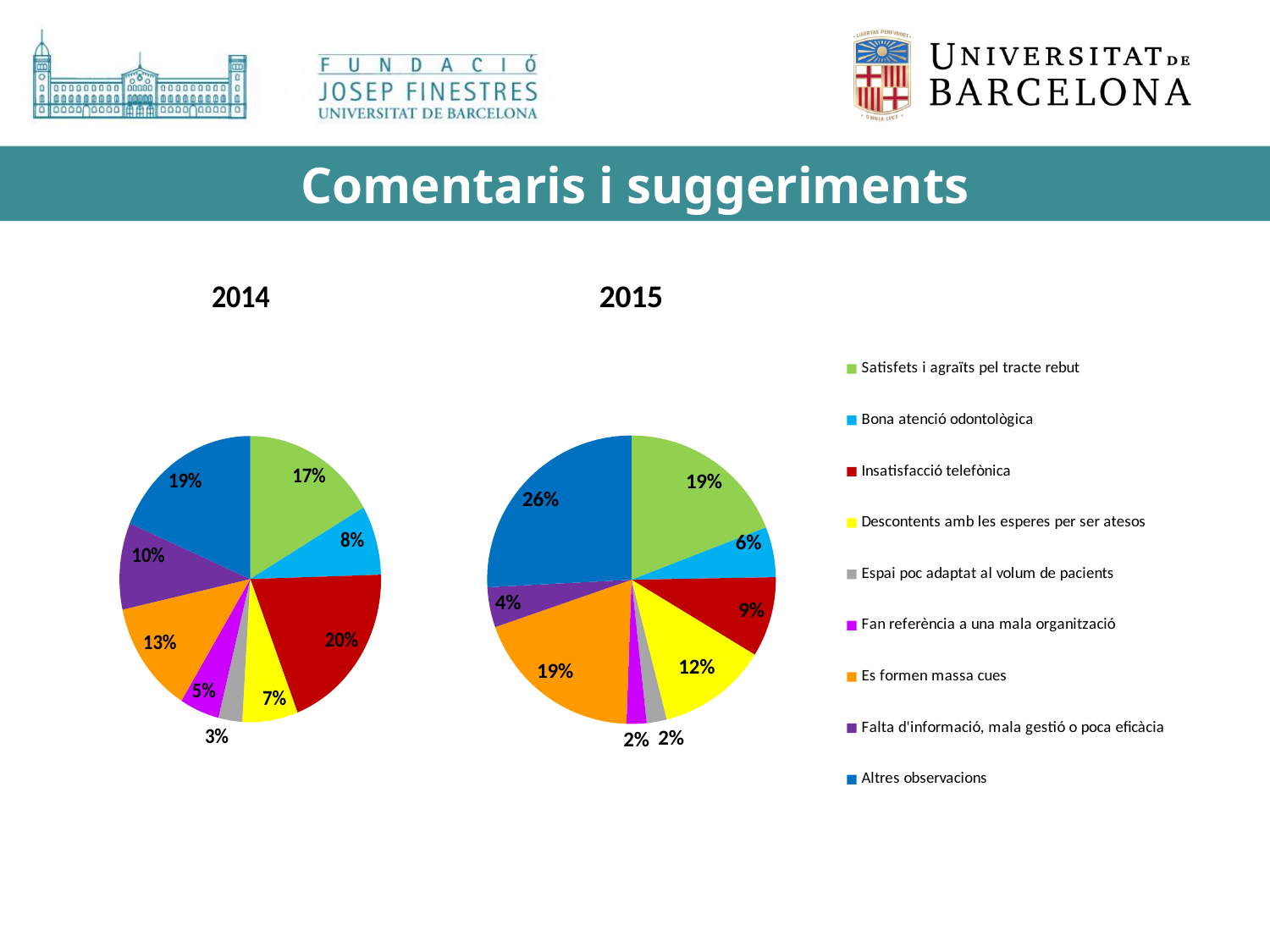
In the 2015 pie chart, what share is labelled for 'Descontents amb les esperes per ser atesos'? 12% How many categories does the legend list? 9 In the 2015 pie chart, what share is labelled for 'Altres observacions'? 26% What type of chart is used for the 2014 and 2015 data? Pie chart In the 2015 pie chart, which category has the largest slice? Altres observacions Which colour represents 'Bona atenció odontològica' in the legend? Light blue In the 2014 pie chart, what share is labelled for 'Es formen massa cues'? 13% Which is larger: the 'Es formen massa cues' share in the 2014 pie chart or in the 2015 pie chart? 2015